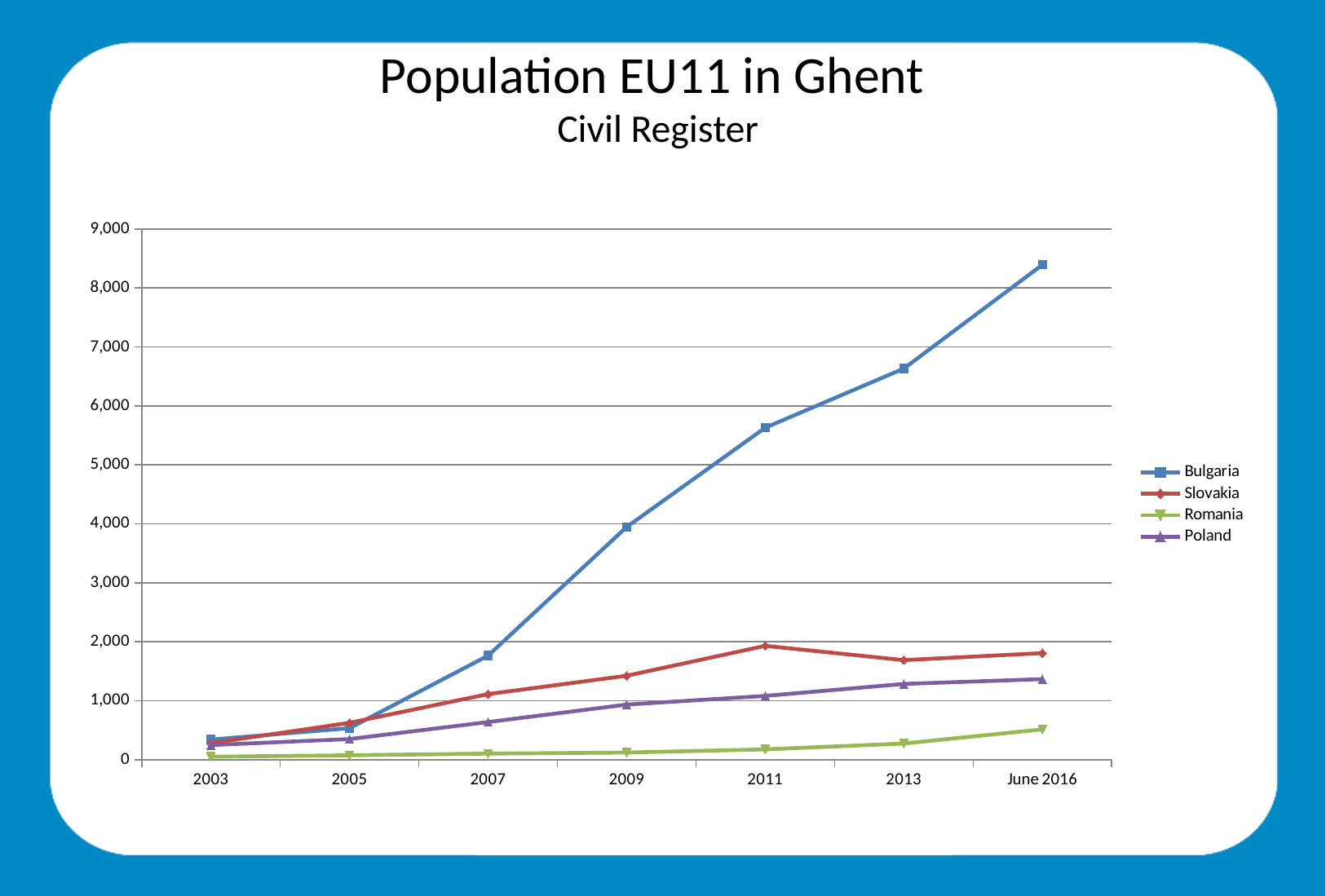
Is the value for Bulgaria in June 2016 greater or less than 8,000? greater Is the value for Poland in June 2016 greater or less than 1,000? greater Is the value for Bulgaria in 2011 greater or less than 5,000? greater How many series does the legend list? 4 Which series has the highest value in June 2016? Bulgaria What is the title of the chart? Population EU11 in Ghent How many time points are shown on the x axis? 7 Which series has the lowest value in June 2016? Romania What kind of chart is shown on the slide? line chart Does the Bulgaria series rise or fall from 2003 to June 2016? rise In 2009, which is larger: the value for Slovakia or the value for Poland? Slovakia